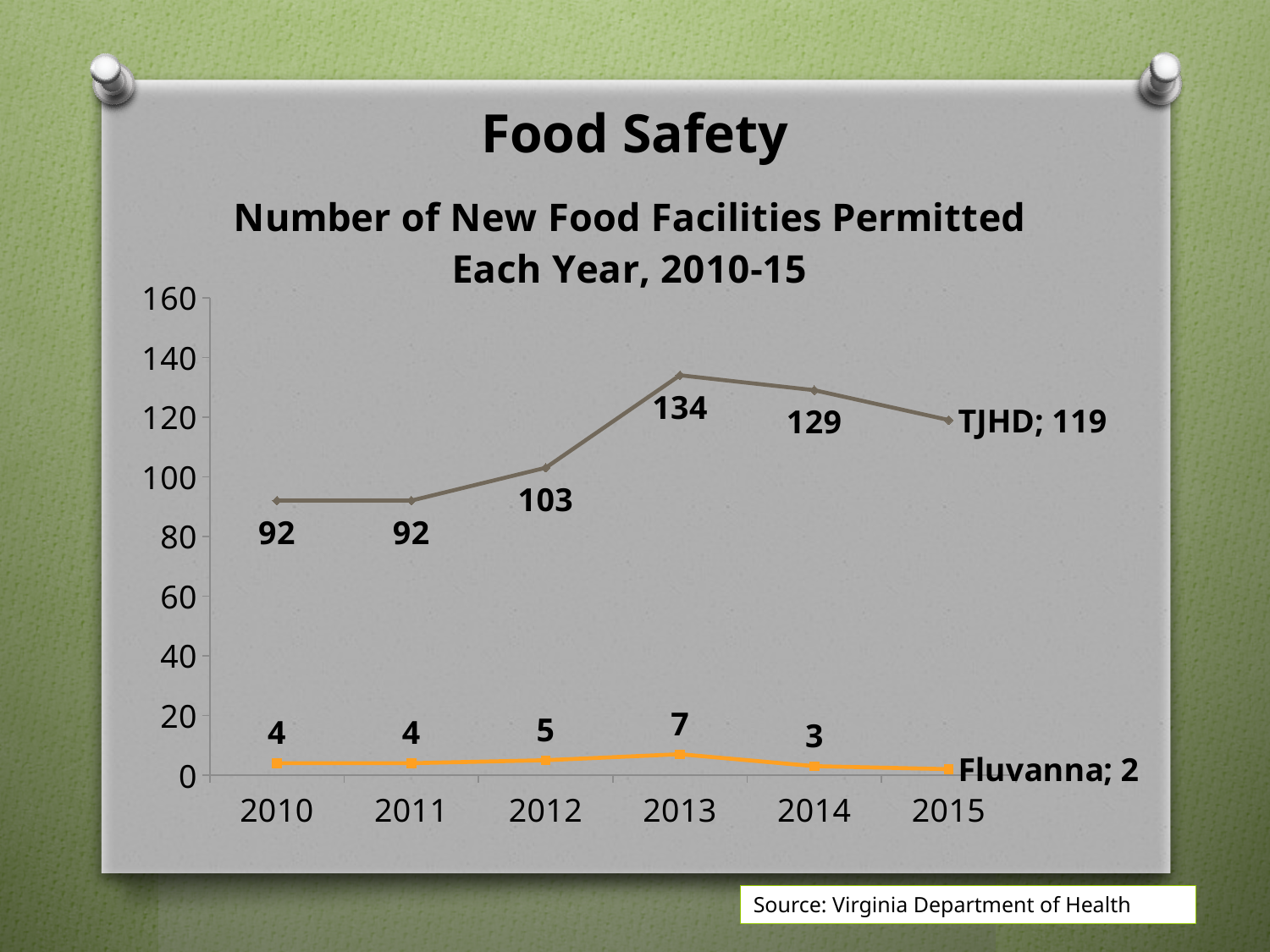
What is the Fluvanna value for 2015? 2 Which is larger, the Fluvanna value for 2013 or for 2014? 2013 In which year is the TJHD value highest? 2013 What is the TJHD value for 2013? 134 In which year is the Fluvanna value lowest? 2015 What type of chart is shown on the slide? line chart Does the TJHD series rise or fall from 2013 to 2015? fall How many series are plotted in the chart? 2 How many years are plotted on the x axis? 6 What is the difference between the TJHD values for 2013 and 2015? 15 What is the title of the chart? Number of New Food Facilities Permitted Each Year, 2010-15 What is the TJHD value for 2012? 103